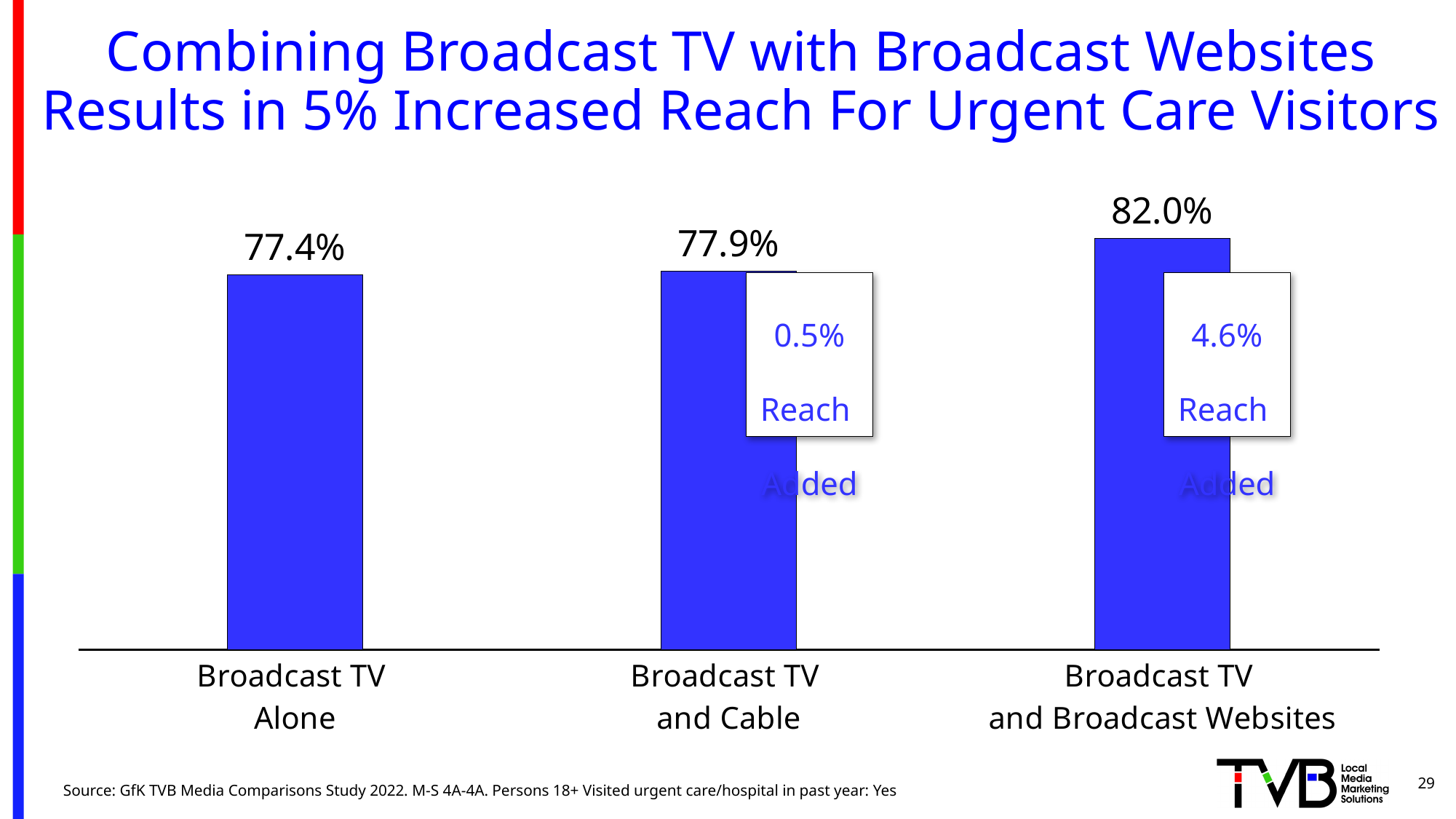
What added reach is shown in the callout box for Broadcast TV and Broadcast Websites? 4.6% Reach Added Which has a larger reach: Broadcast TV and Cable or Broadcast TV and Broadcast Websites? Broadcast TV and Broadcast Websites What is the reach value for Broadcast TV and Broadcast Websites? 82.0% Which category has the highest reach? Broadcast TV and Broadcast Websites What kind of chart is shown on the slide? Bar chart What is the difference in reach between Broadcast TV and Cable and Broadcast TV Alone? 0.5% What is the reach value for Broadcast TV and Cable? 77.9% What is the reach value for Broadcast TV Alone? 77.4% How many categories are shown in the chart? 3 Which category has the lowest reach? Broadcast TV Alone What is the difference in reach between Broadcast TV and Broadcast Websites and Broadcast TV Alone? 4.6% Do the reach values rise or fall from left to right across the categories? Rise